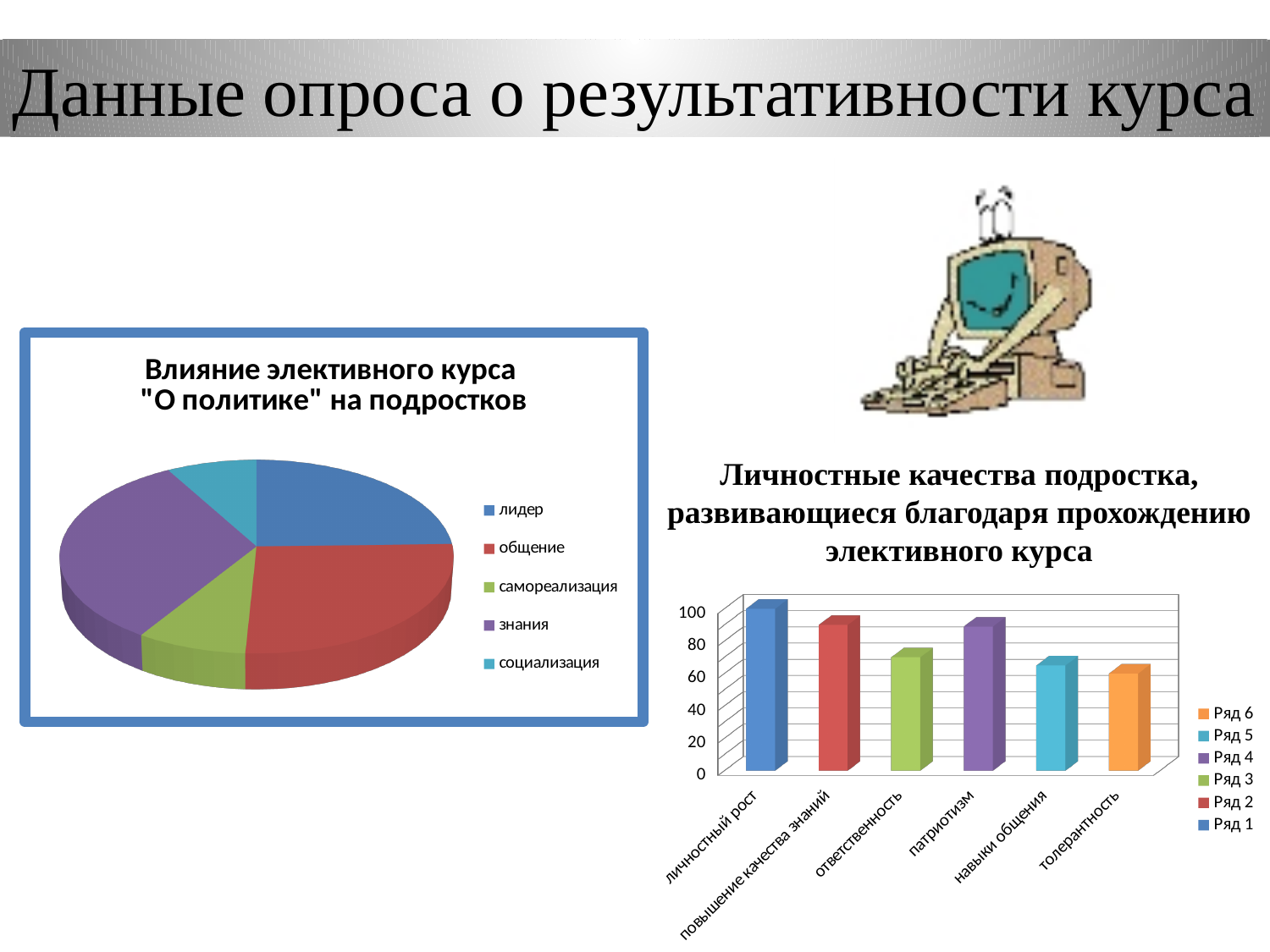
How many series does the legend of the bar chart "Личностные качества подростка, развивающиеся благодаря прохождению элективного курса" list? 6 In the bar chart "Личностные качества подростка, развивающиеся благодаря прохождению элективного курса", which category has the highest bar? личностный рост In the bar chart "Личностные качества подростка, развивающиеся благодаря прохождению элективного курса", is the value for толерантность greater or less than 80? less In the bar chart "Личностные качества подростка, развивающиеся благодаря прохождению элективного курса", which is larger: личностный рост or навыки общения? личностный рост In the bar chart "Личностные качества подростка, развивающиеся благодаря прохождению элективного курса", is the value for ответственность greater or less than 60? greater In the pie chart "Влияние элективного курса "О политике" на подростков", which slice is larger: самореализация or знания? знания What kind of chart is the chart titled "Влияние элективного курса "О политике" на подростков"? pie chart How many categories are shown on the x axis of the bar chart "Личностные качества подростка, развивающиеся благодаря прохождению элективного курса"? 6 In the pie chart "Влияние элективного курса "О политике" на подростков", which colour represents общение? red What kind of chart is the chart titled "Личностные качества подростка, развивающиеся благодаря прохождению элективного курса"? bar chart How many categories does the legend of the pie chart "Влияние элективного курса "О политике" на подростков" list? 5